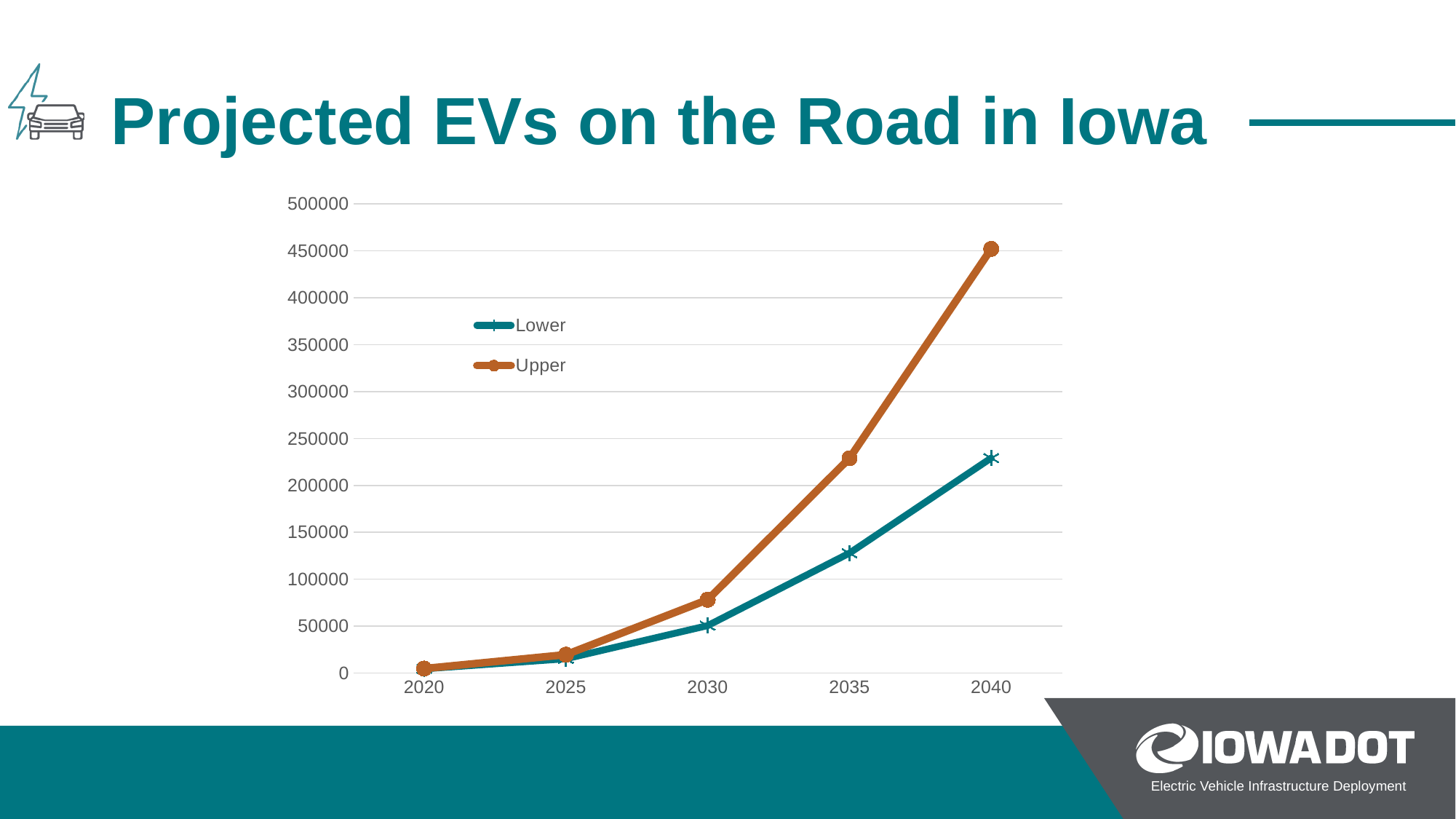
In which year does the Upper series reach its highest value? 2040 Which two series are listed in the legend? Lower and Upper What kind of chart is shown on the slide? line chart Is the value for the Upper series in 2030 greater or less than 100000? less Do the values of the Upper series rise or fall from 2020 to 2040? rise What is the title of the chart? Projected EVs on the Road in Iowa How many years are plotted along the x axis? 5 How many series does the legend list? 2 In 2040, which series has the larger value, Lower or Upper? Upper Is the value for the Lower series in 2035 greater or less than 100000? greater Is the value for the Upper series in 2040 greater or less than 400000? greater In which year is the Lower series at its lowest value? 2020